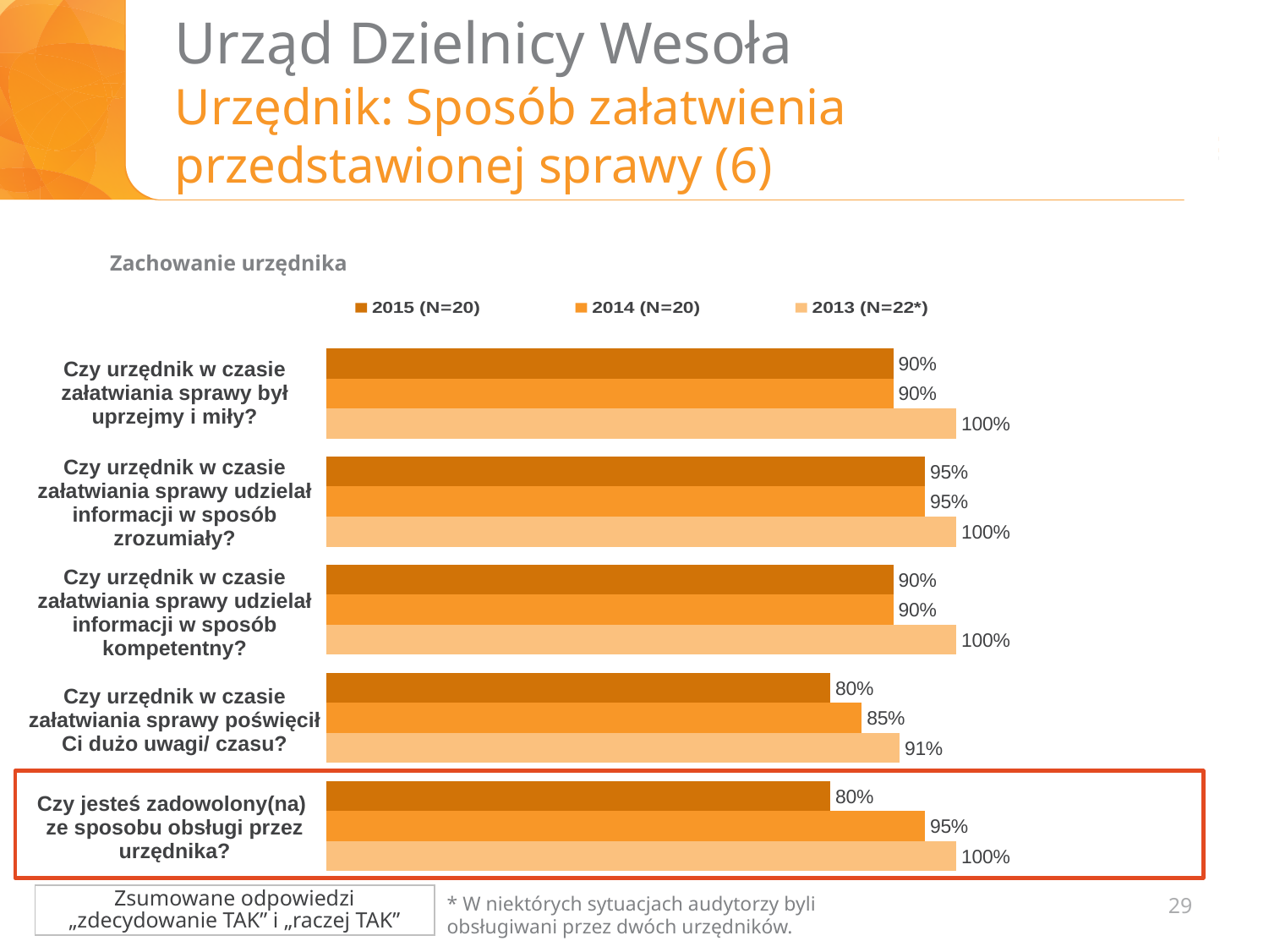
What is the difference between the 2014 (N=20) and 2015 (N=20) values for "Czy jesteś zadowolony(na) ze sposobu obsługi przez urzędnika?"? 15 percentage points For "Czy urzędnik w czasie załatwiania sprawy poświęcił Ci dużo uwagi/ czasu?", which is larger: the 2014 (N=20) value or the 2015 (N=20) value? 2014 (N=20) What is the 2015 (N=20) value for "Czy urzędnik w czasie załatwiania sprawy udzielał informacji w sposób zrozumiały?"? 95% What is the 2015 (N=20) value for "Czy jesteś zadowolony(na) ze sposobu obsługi przez urzędnika?"? 80% How many question categories are plotted in the chart? 5 Which category has the lowest 2013 (N=22*) value? Czy urzędnik w czasie załatwiania sprawy poświęcił Ci dużo uwagi/ czasu? What is the difference between the 2013 (N=22*) and 2015 (N=20) values for "Czy jesteś zadowolony(na) ze sposobu obsługi przez urzędnika?"? 20 percentage points What type of chart is shown on the slide? bar chart What is the 2014 (N=20) value for "Czy urzędnik w czasie załatwiania sprawy poświęcił Ci dużo uwagi/ czasu?"? 85% What is the title shown above the chart? Zachowanie urzędnika How many series does the chart legend list? 3 What is the 2013 (N=22*) value for "Czy urzędnik w czasie załatwiania sprawy poświęcił Ci dużo uwagi/ czasu?"? 91%